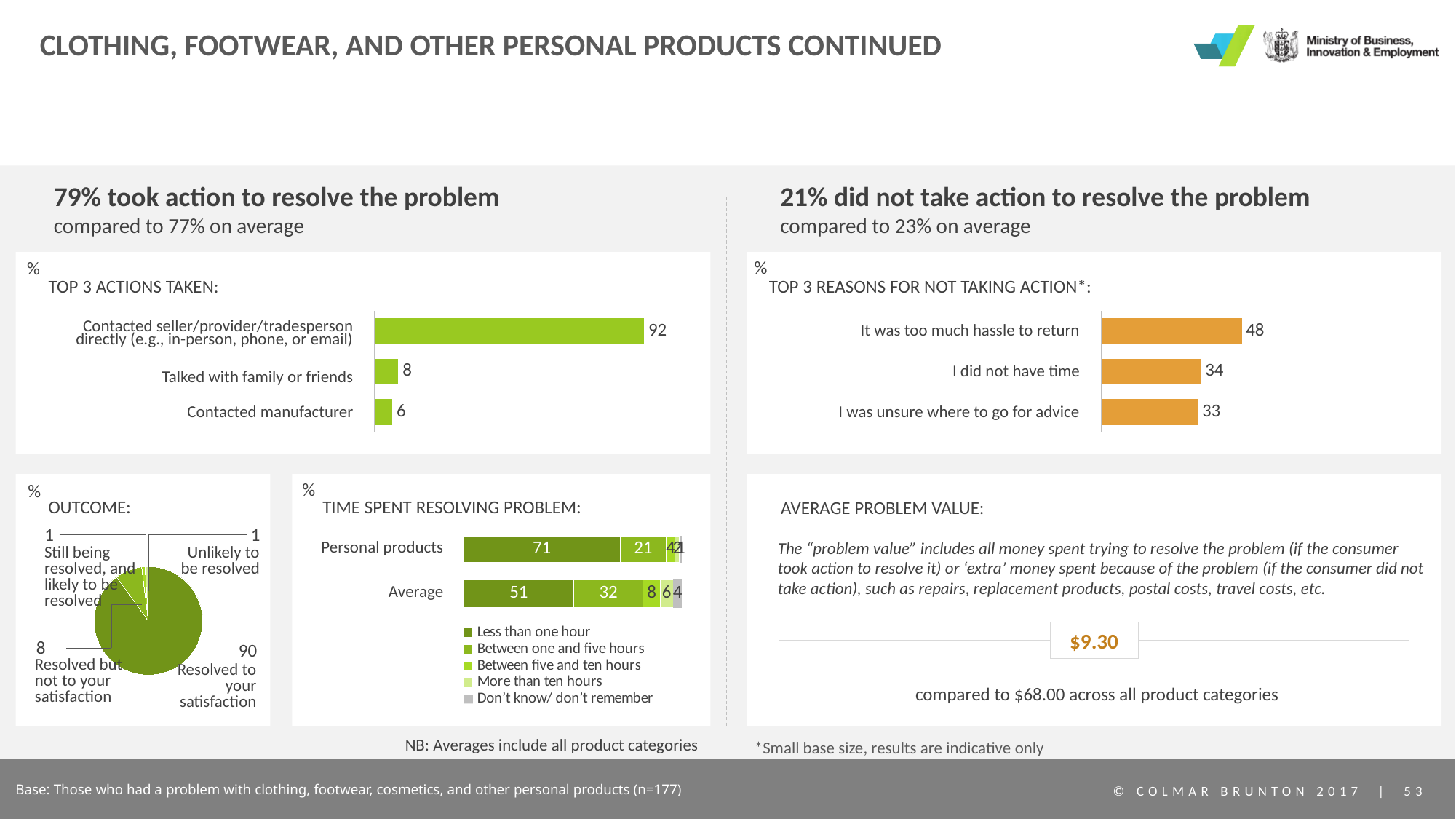
In the 'Time spent resolving problem' chart, which is larger for 'Between one and five hours': 'Personal products' or 'Average'? Average In the 'Time spent resolving problem' chart, how many series does the legend list? 5 In the 'Top 3 reasons for not taking action' chart, what is the value for 'I did not have time'? 34 In the 'Top 3 reasons for not taking action' chart, how many reasons are shown? 3 In the 'Top 3 reasons for not taking action' chart, which reason has the highest value? It was too much hassle to return In the 'Top 3 actions taken' chart, what is the value for 'Contacted seller/provider/tradesperson directly'? 92 In the 'Top 3 reasons for not taking action' chart, what is the difference between 'It was too much hassle to return' and 'I was unsure where to go for advice'? 15 In the 'Top 3 actions taken' chart, what is the difference between 'Talked with family or friends' and 'Contacted manufacturer'? 2 In the 'Top 3 actions taken' chart, which action has the lowest value? Contacted manufacturer In the 'Outcome' pie chart, which outcome has the largest slice? Resolved to your satisfaction In the 'Outcome' pie chart, what share is 'Resolved to your satisfaction'? 90 In the 'Time spent resolving problem' chart, what is the 'Less than one hour' value for 'Personal products'? 71